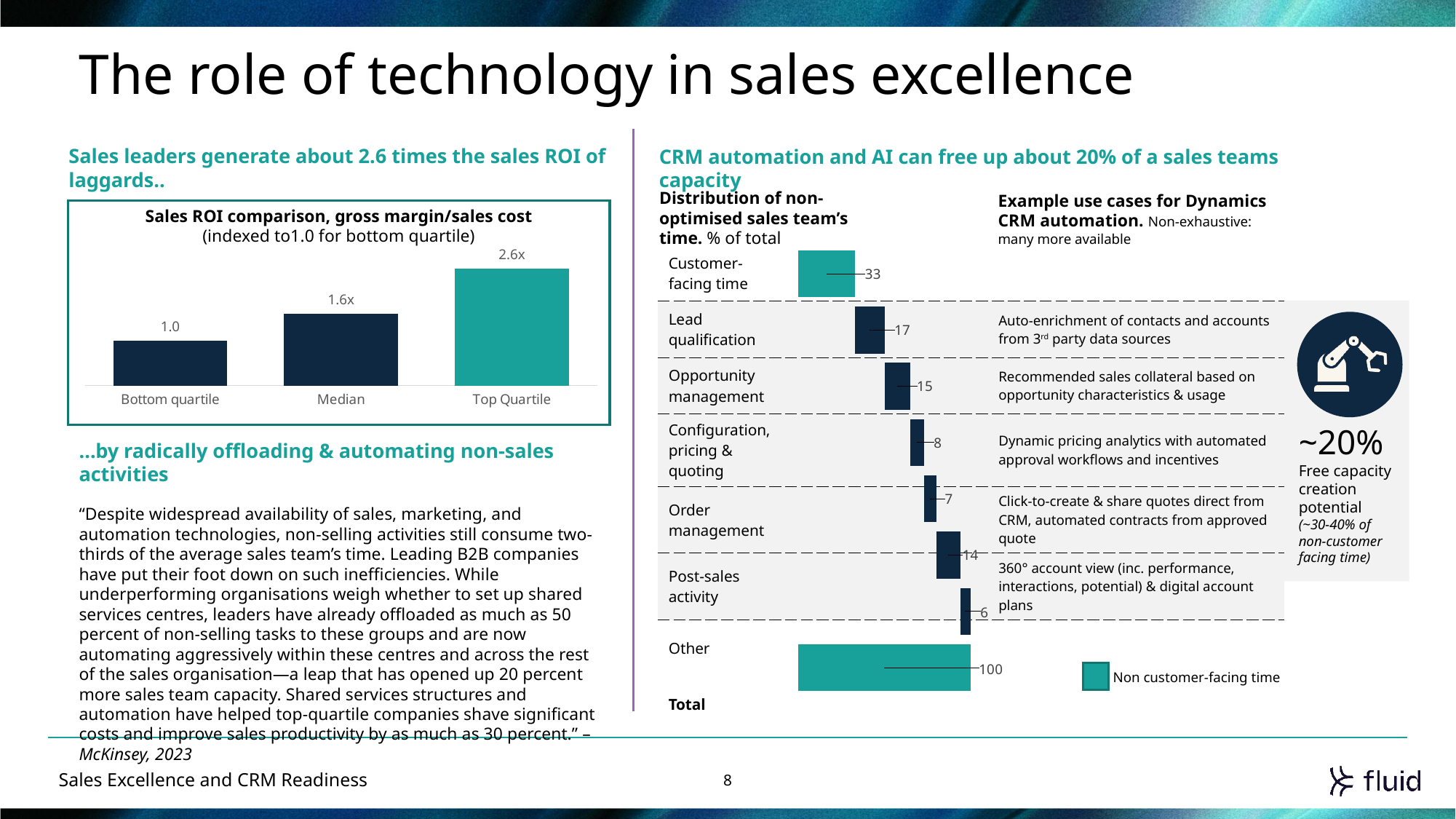
In the Distribution of non-optimised sales team's time chart, what is the difference between Lead qualification and Opportunity management? 2 In the Distribution of non-optimised sales team's time chart, what is the value for Customer-facing time? 33 In the Distribution of non-optimised sales team's time chart, what is the value shown for Total? 100 In the Distribution of non-optimised sales team's time chart, what is the value for Post-sales activity? 14 In the Sales ROI comparison chart, how many categories are shown? 3 In the Sales ROI comparison chart, what is the value for the Top Quartile? 2.6x What kind of chart is the Sales ROI comparison chart? Bar chart In the Sales ROI comparison chart, do the values rise or fall from Bottom quartile to Top Quartile? Rise In the Distribution of non-optimised sales team's time chart, which is larger, Configuration, pricing & quoting or Order management? Configuration, pricing & quoting In the Distribution of non-optimised sales team's time chart, what is the value for Lead qualification? 17 In the Sales ROI comparison chart, which category has the lowest value? Bottom quartile In the Sales ROI comparison chart, what is the value for the Median? 1.6x